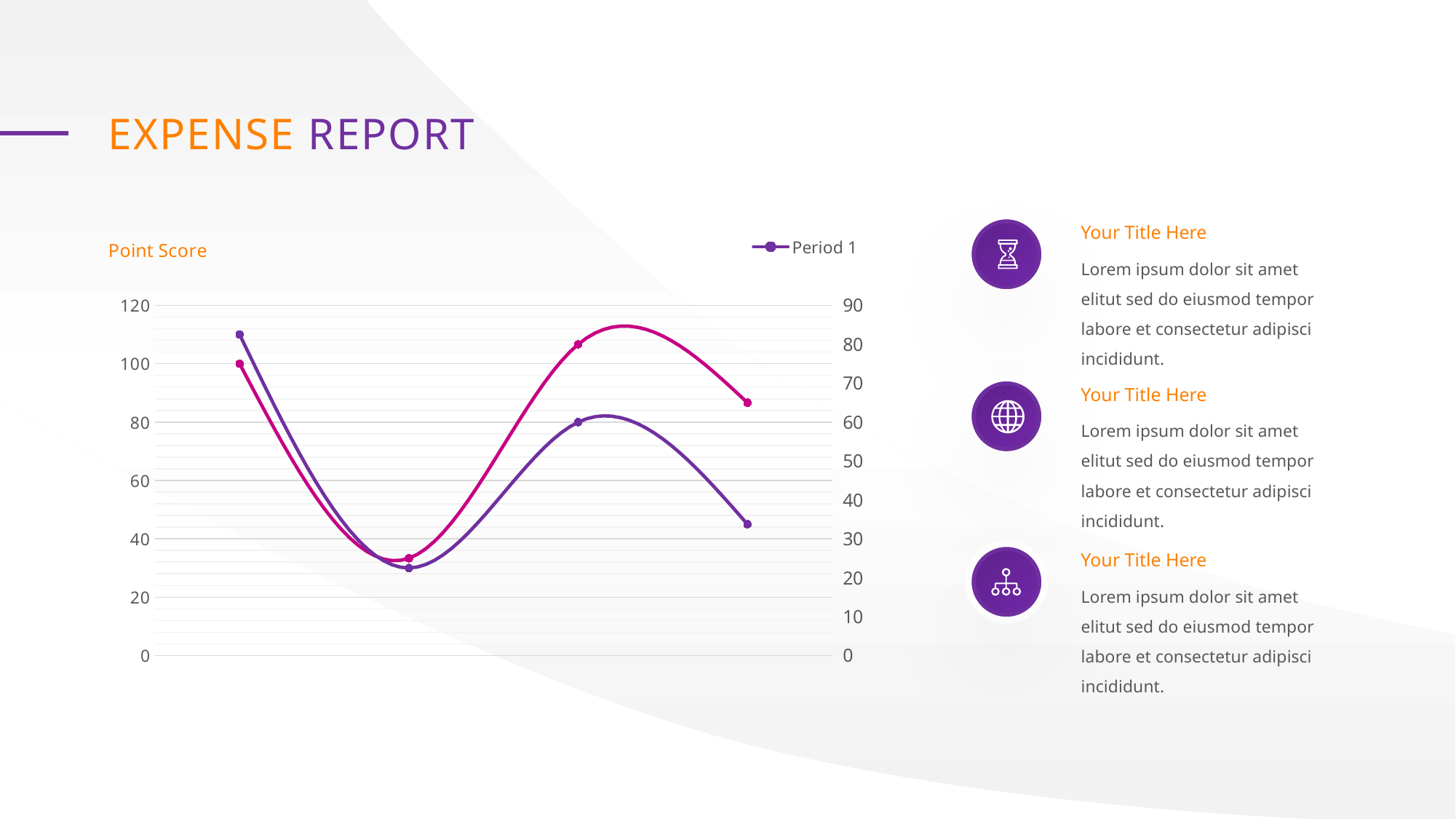
Which point on the purple Period 1 line is the lowest? the second point How many lines are plotted on the chart? 2 How many series does the chart legend list? 1 At the third data point, which line is plotted higher, the purple line or the magenta line? the magenta line Does the purple Period 1 line rise or fall between its first and second points? fall Does the purple Period 1 line rise or fall between its third and fourth points? fall How many data points are plotted on the purple Period 1 line? 4 What is the name of the series listed in the chart legend? Period 1 What is the title of the chart? Point Score What kind of chart is shown on the slide? line chart Does the purple Period 1 line rise or fall between its second and third points? rise Which point on the purple Period 1 line is the highest? the first point